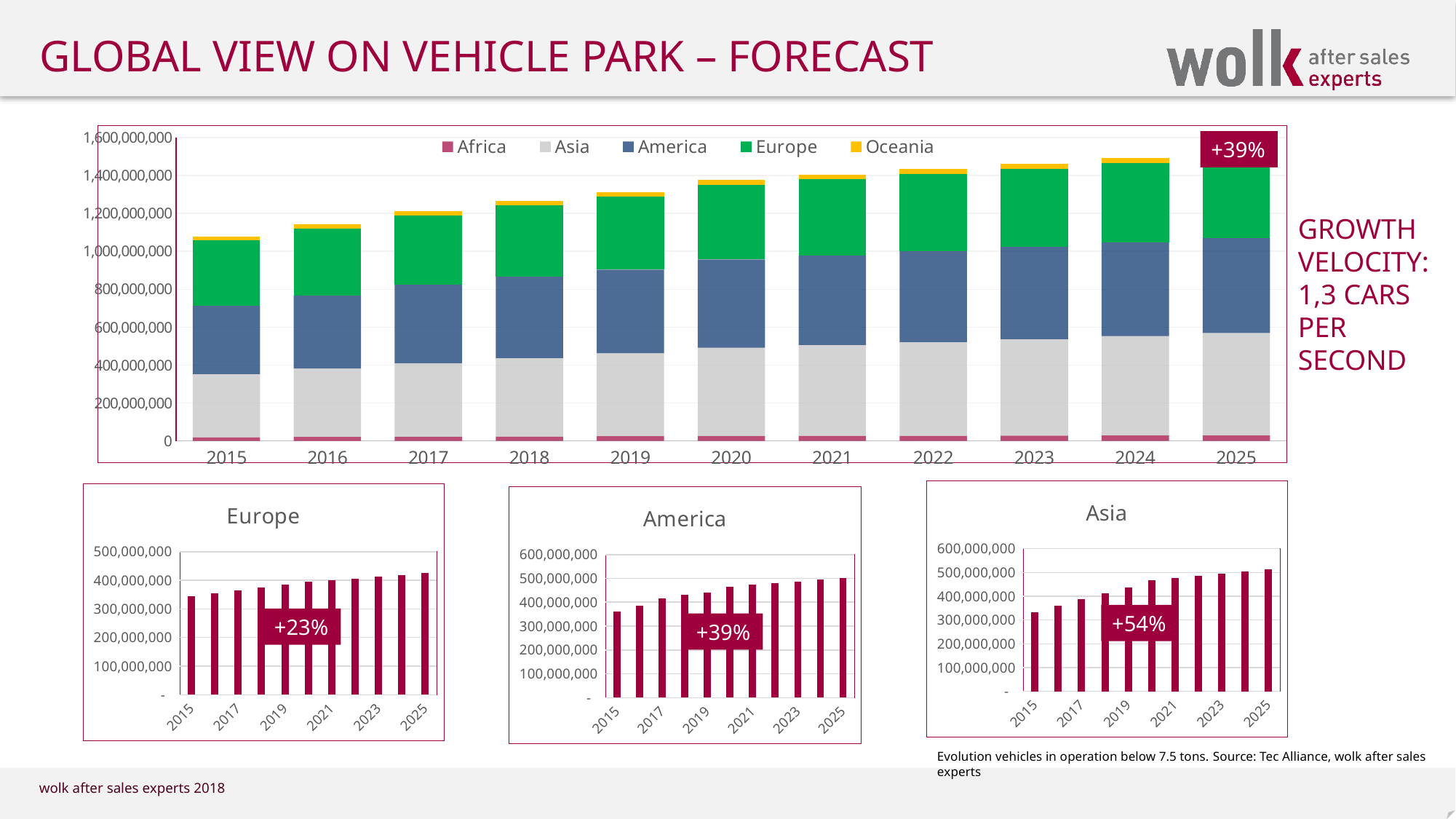
What kind of chart is the large chart at the top of the slide? stacked bar chart In the Asia chart, do the values rise or fall from 2015 to 2025? rise How many series does the legend of the top stacked bar chart list? 5 How many years are shown on the x axis of the top stacked bar chart? 11 In the top stacked bar chart, which year has the lowest total? 2015 Which of the three small regional charts shows the largest growth percentage label? Asia (+54%) In the top stacked bar chart, is the total for 2015 greater or less than 1,000,000,000? greater In the top stacked bar chart, which year has the highest total? 2025 In the top stacked bar chart, is the total for 2025 greater or less than 1,400,000,000? greater In the Europe chart, is the value for 2015 greater or less than 300,000,000? greater In the top stacked bar chart, which segment is larger in 2025, Europe or Oceania? Europe